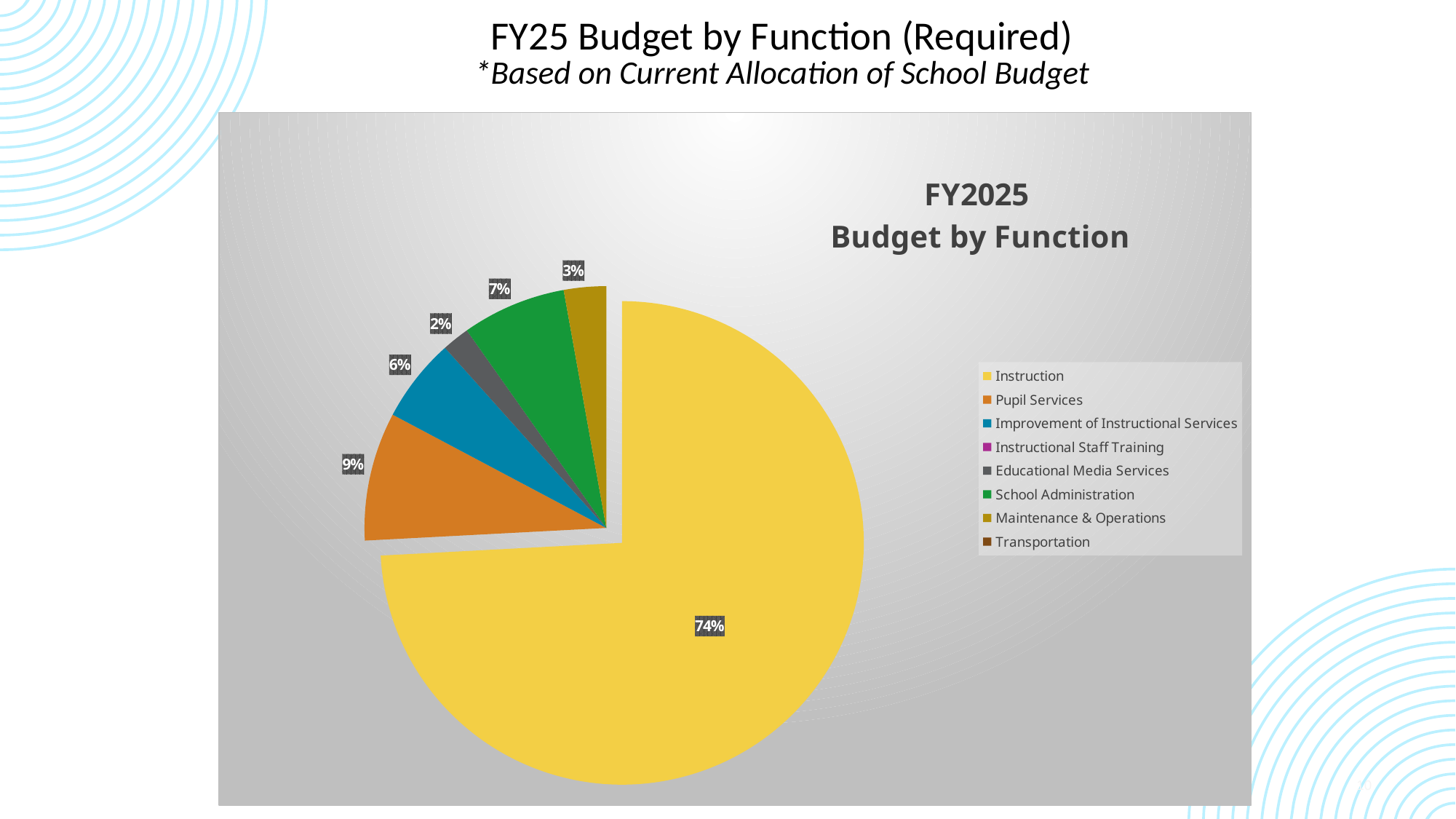
Which is larger, the share for Pupil Services or the share for School Administration? Pupil Services How many entries does the legend list? 8 What type of chart is shown on the slide? Pie chart What is the difference in percentage points between the Instruction share and the Pupil Services share? 65 What percentage of the FY2025 budget goes to Pupil Services? 9% What percentage of the FY2025 budget goes to Educational Media Services? 2% What is the title shown inside the chart area? FY2025 Budget by Function What percentage of the FY2025 budget goes to Instruction? 74% What percentage of the FY2025 budget goes to Improvement of Instructional Services? 6% What percentage of the FY2025 budget goes to School Administration? 7% Which function receives the largest share of the FY2025 budget? Instruction What percentage of the FY2025 budget goes to Maintenance & Operations? 3%